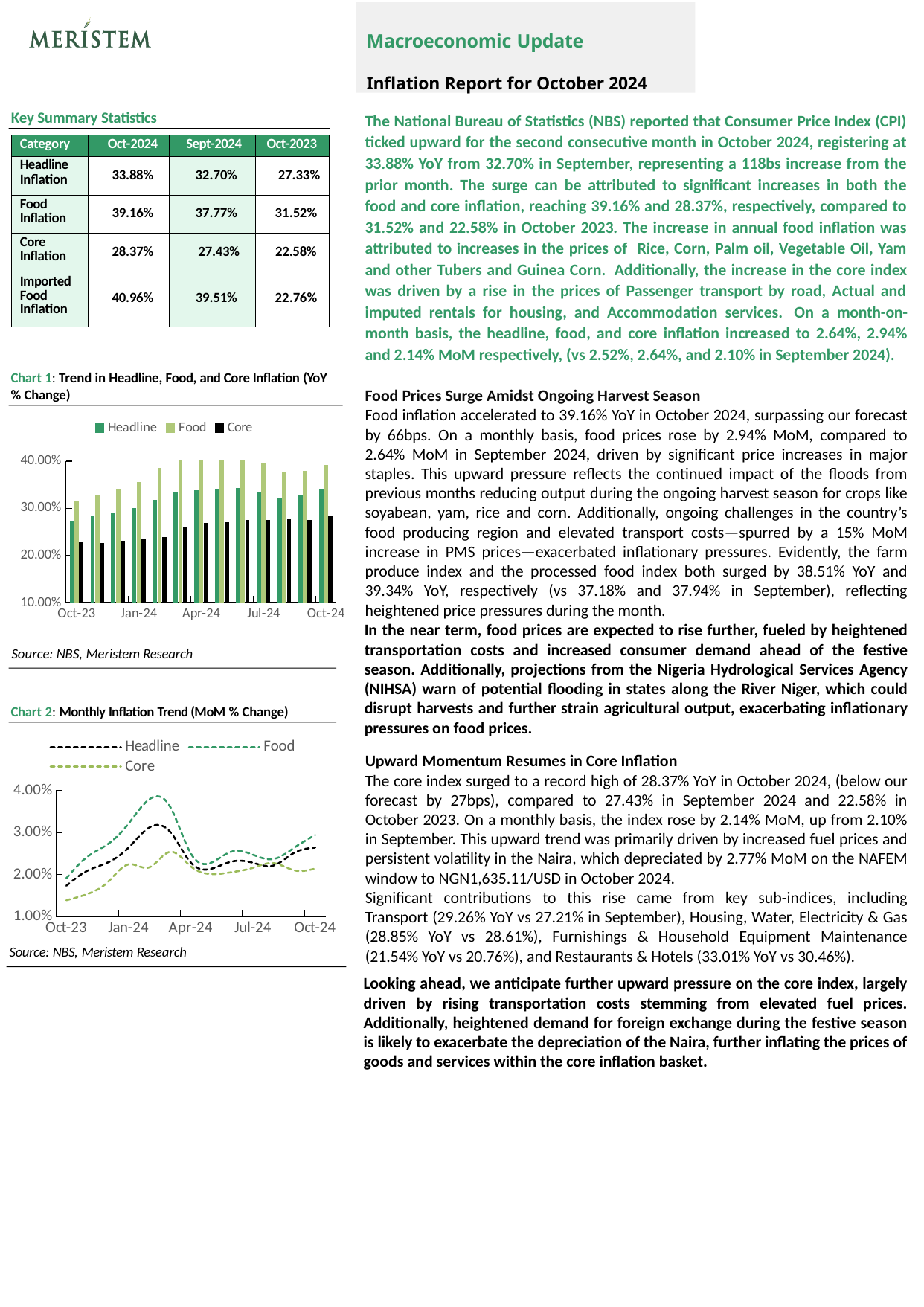
In Chart 1, which series has the lowest bars across the period shown? Core In Chart 2, is the Core value at Oct-23 greater or less than 2.00%? less Which series are listed in the legend of Chart 2? Headline, Food, Core In Chart 1, is the Food value for Oct-24 greater or less than 30.00%? greater In Chart 1, is the Headline value for Oct-23 greater or less than 30.00%? less In Chart 2, which is larger at Jan-24, the Food line or the Core line? Food In Chart 1, which series has the highest bars across the period shown? Food In Chart 1, do the Core inflation bars generally rise or fall from Oct-23 to Oct-24? rise What kind of chart is Chart 2 (Monthly Inflation Trend)? line chart What kind of chart is Chart 1 (Trend in Headline, Food, and Core Inflation)? bar chart How many series does the legend of Chart 1 list? 3